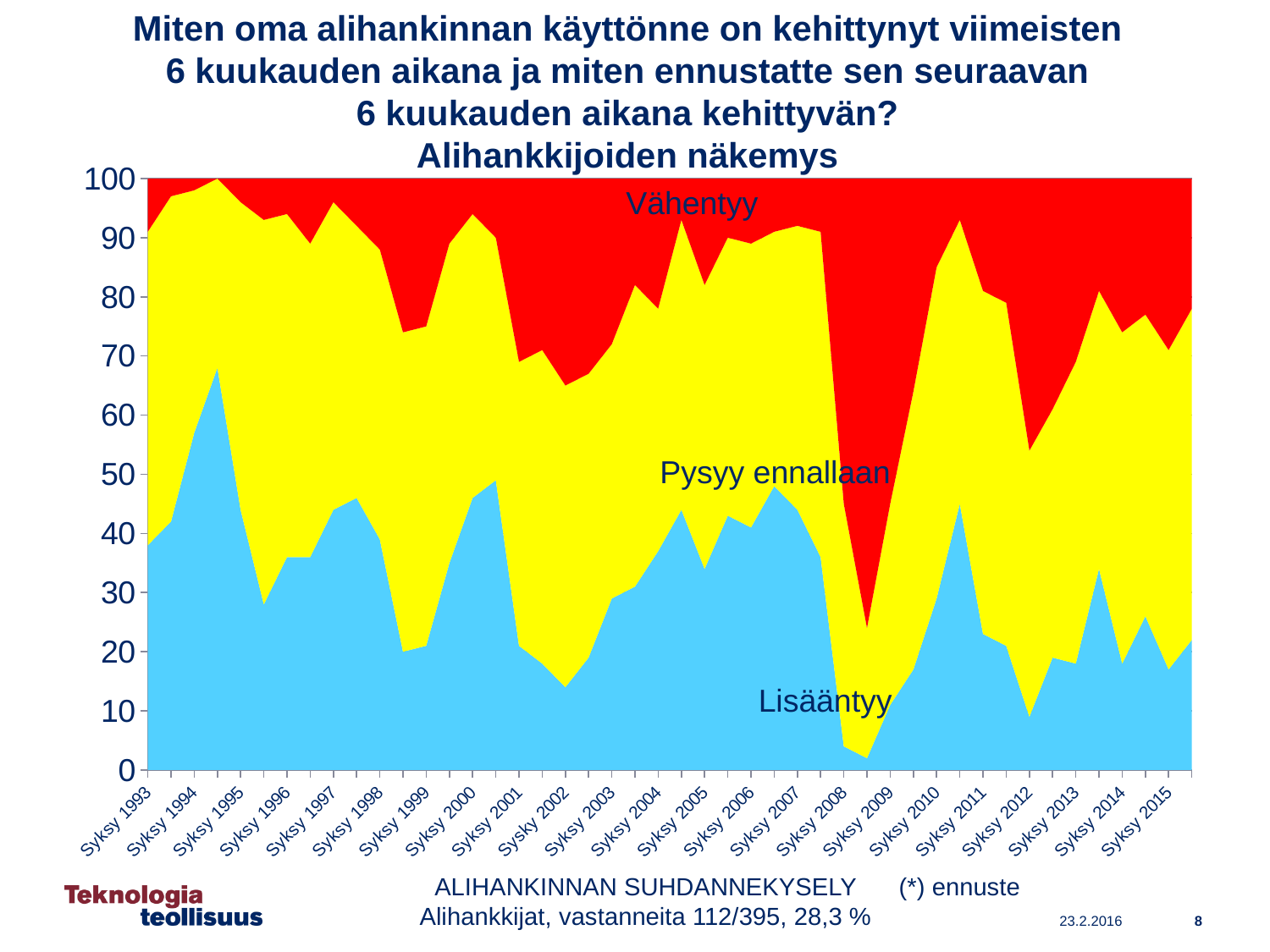
How many labelled points are there on the x axis of the chart? 23 Is the value for Lisääntyy at Syksy 1993 greater or less than 50? less What colour is the Vähentyy area in the chart? red Which series is drawn at the bottom of the stacked area chart? Lisääntyy Is the value for Vähentyy at Syksy 2007 greater or less than 20? less Is the highest value reached by the Lisääntyy series greater or less than 60? greater How many series are plotted in the chart? 3 What kind of chart is shown on the slide? stacked area chart Does the Lisääntyy series rise or fall from Syksy 2007 to Syksy 2008? fall